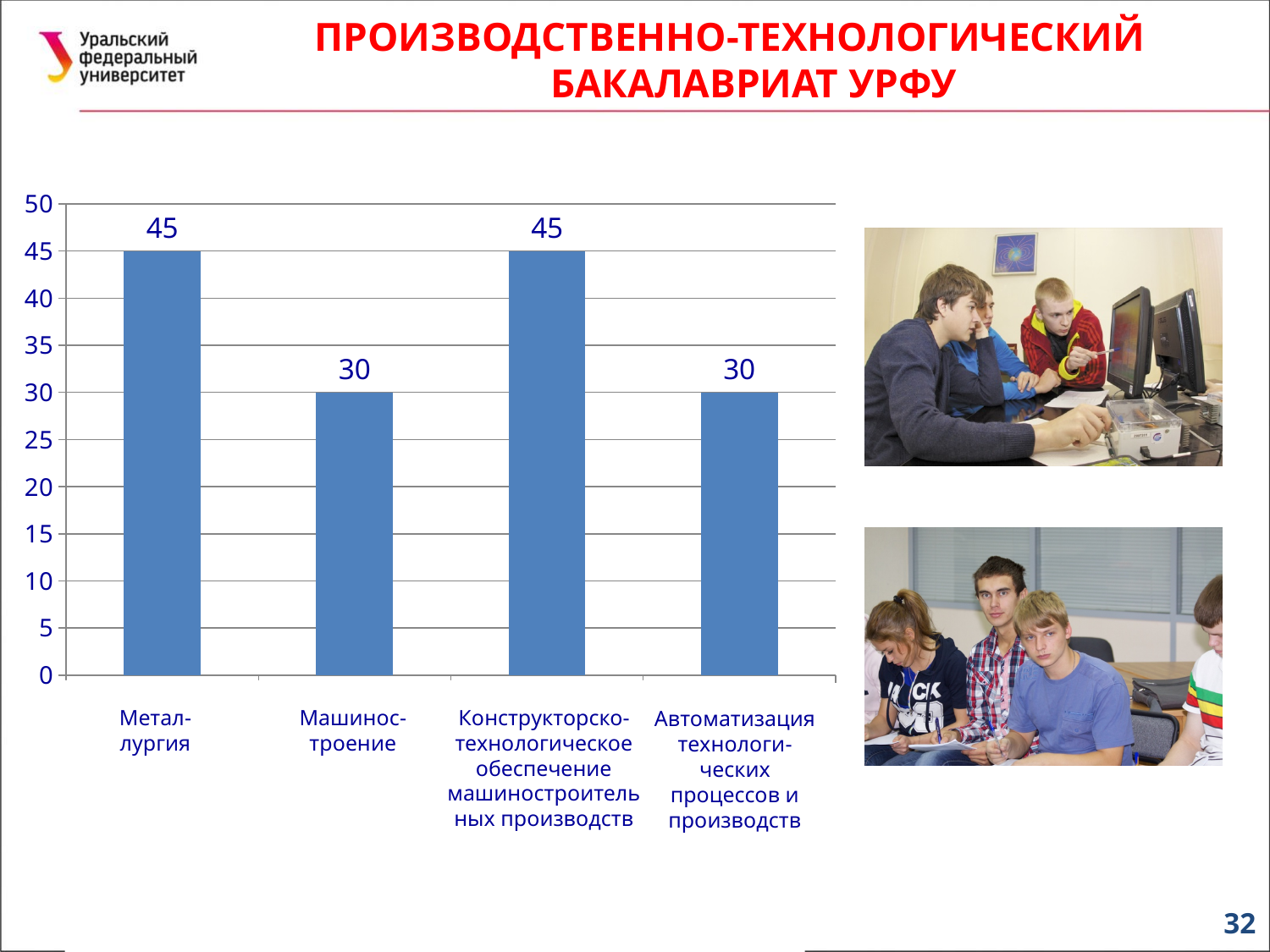
What is the value for Машиностроение? 30 What is the value for Металлургия? 45 What is the difference between the values for Конструкторско-технологическое обеспечение машиностроительных производств and Автоматизация технологических процессов и производств? 15 What is the value for Конструкторско-технологическое обеспечение машиностроительных производств? 45 Which is larger, the value for Машиностроение or the value for Конструкторско-технологическое обеспечение машиностроительных производств? Конструкторско-технологическое обеспечение машиностроительных производств How many categories are shown in the chart? 4 Is the value for Машиностроение greater or less than 40? less What is the difference between the values for Металлургия and Машиностроение? 15 Which is larger, the value for Металлургия or the value for Автоматизация технологических процессов и производств? Металлургия Is the value for Металлургия greater or less than 40? greater What kind of chart is shown on the slide? bar chart What is the value for Автоматизация технологических процессов и производств? 30